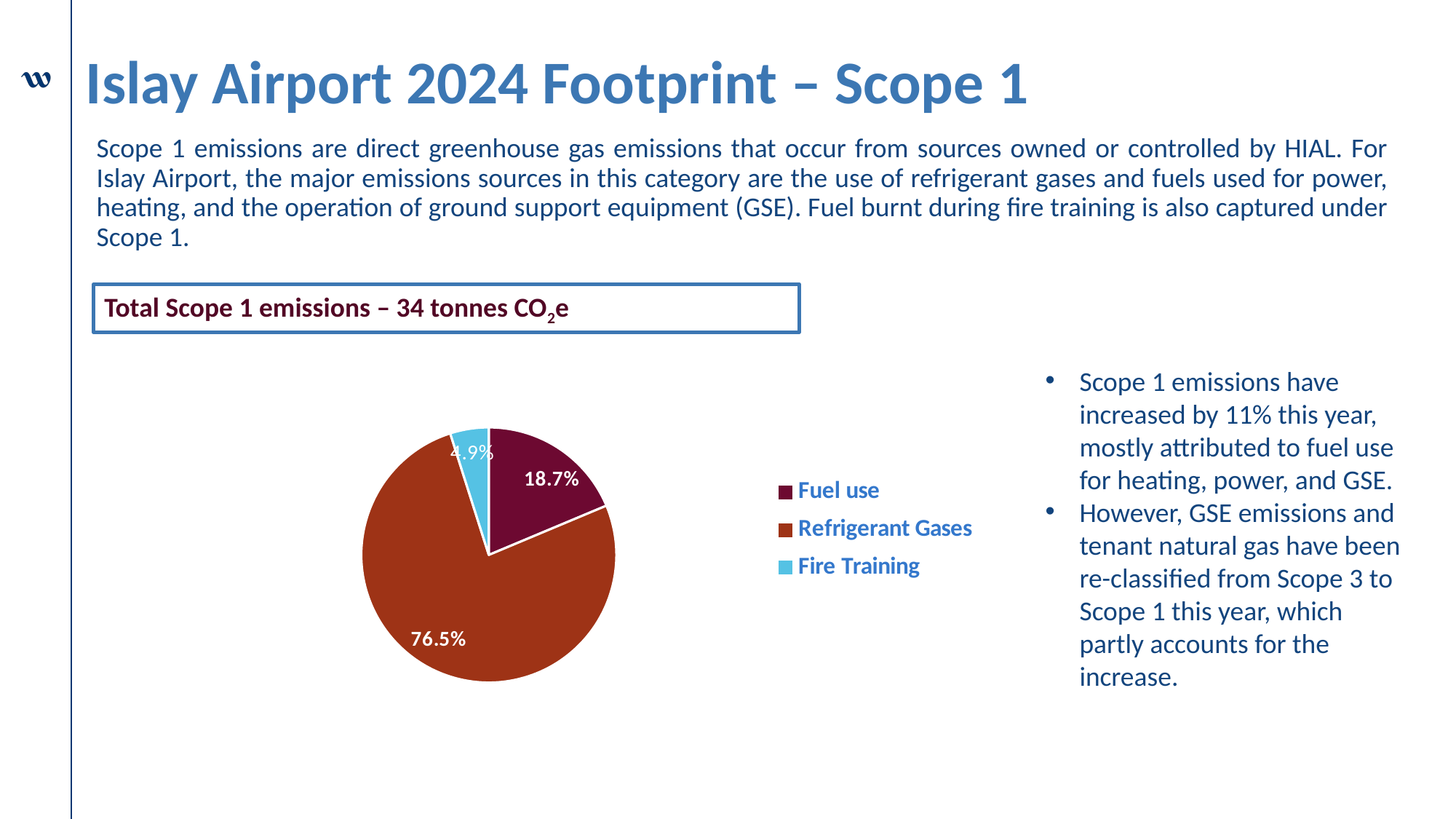
What share of the pie does Fuel use account for? 18.7% What is the difference in percentage points between the Fuel use share and the Fire Training share? 13.8 Which category has the largest slice of the pie? Refrigerant Gases How many categories does the pie chart show? 3 What share of the pie does Refrigerant Gases account for? 76.5% Which legend entry is shown in light blue? Fire Training What is the difference in percentage points between the Refrigerant Gases share and the Fuel use share? 57.8 What kind of chart is shown on the slide? pie chart What share of the pie does Fire Training account for? 4.9% How many entries does the legend list? 3 Which is larger, the share for Fuel use or the share for Fire Training? Fuel use Which category has the smallest slice of the pie? Fire Training